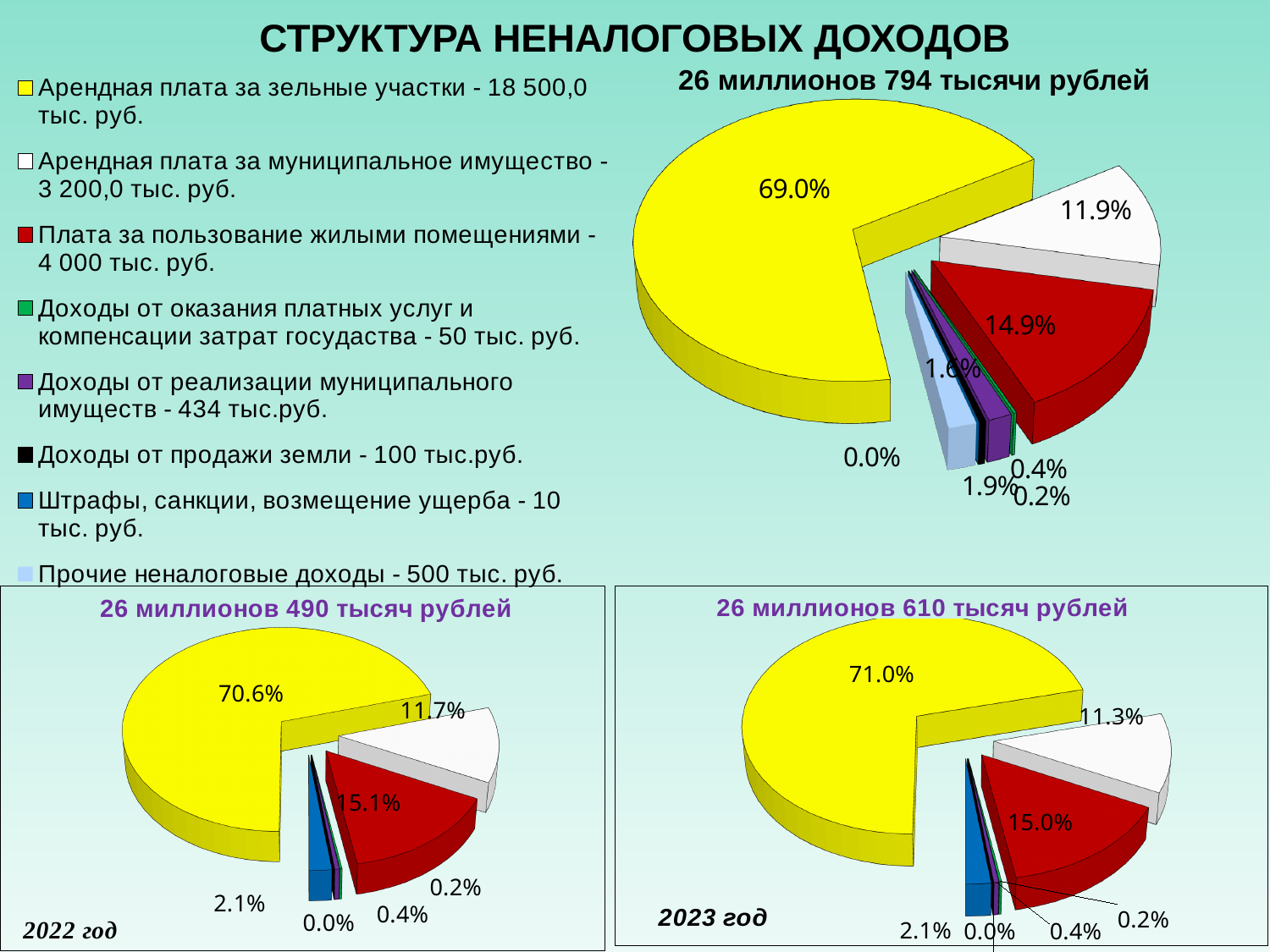
In the bottom-right pie chart (2023 год), what share is shown for the yellow slice? 71.0% How many categories does the legend on the left of the slide list? 8 In the top-right pie chart (26 миллионов 794 тысячи рублей), which slice has the largest share? Арендная плата за земельные участки (69.0%) In the bottom-right pie chart (2023 год), what share is shown for the white slice? 11.3% In the bottom-left pie chart (2022 год), which is larger: the red slice or the white slice? The red slice (15.1%) In the top-right pie chart (26 миллионов 794 тысячи рублей), by how many percentage points does the yellow slice (69.0%) exceed the red slice (14.9%)? 54.1 percentage points What type of chart is used on this slide? Pie chart In the bottom-left pie chart (2022 год), what share is shown for the red slice? 15.1% In the top-right pie chart (26 миллионов 794 тысячи рублей), what share is shown for the yellow slice (Арендная плата за земельные участки)? 69.0% In the bottom-left pie chart (2022 год), what share is shown for the yellow slice? 70.6% In the top-right pie chart (26 миллионов 794 тысячи рублей), what share is shown for the white slice (Арендная плата за муниципальное имущество)? 11.9% In the top-right pie chart (26 миллионов 794 тысячи рублей), what share is shown for the red slice (Плата за пользование жилыми помещениями)? 14.9%